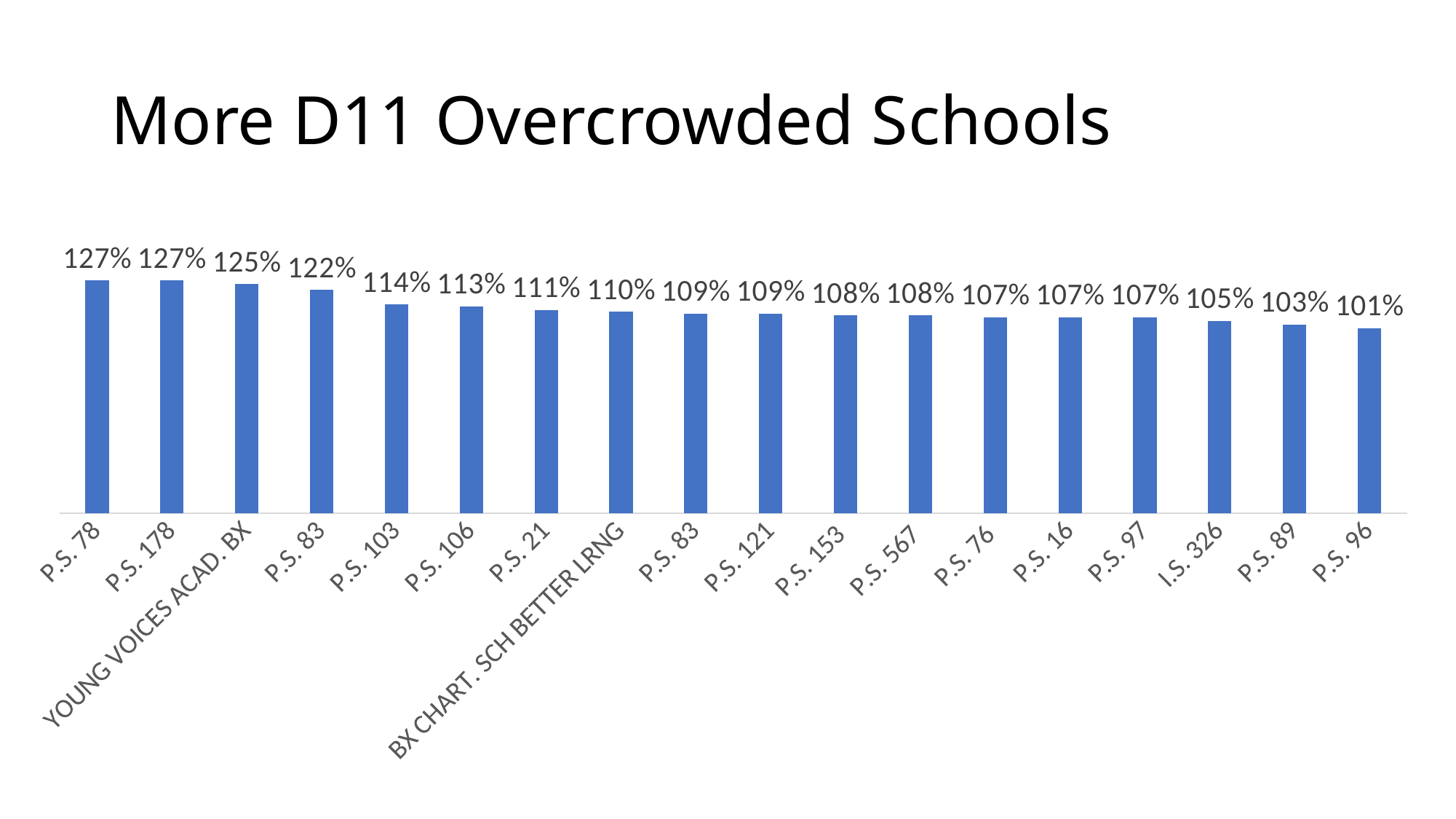
What is the value for P.S. 103? 114% How many schools are shown in the chart? 18 What is the difference between the values for P.S. 78 and P.S. 96? 26% What is the value for I.S. 326? 105% What is the value for YOUNG VOICES ACAD. BX? 125% Which school has the lowest value? P.S. 96 What is the value for BX CHART. SCH BETTER LRNG? 110% Do the values rise or fall from left to right along the x axis? fall Which has a larger value, P.S. 21 or P.S. 153? P.S. 21 What is the value for P.S. 178? 127% What kind of chart is shown on the slide? bar chart What is the difference between the values for P.S. 106 and P.S. 89? 10%